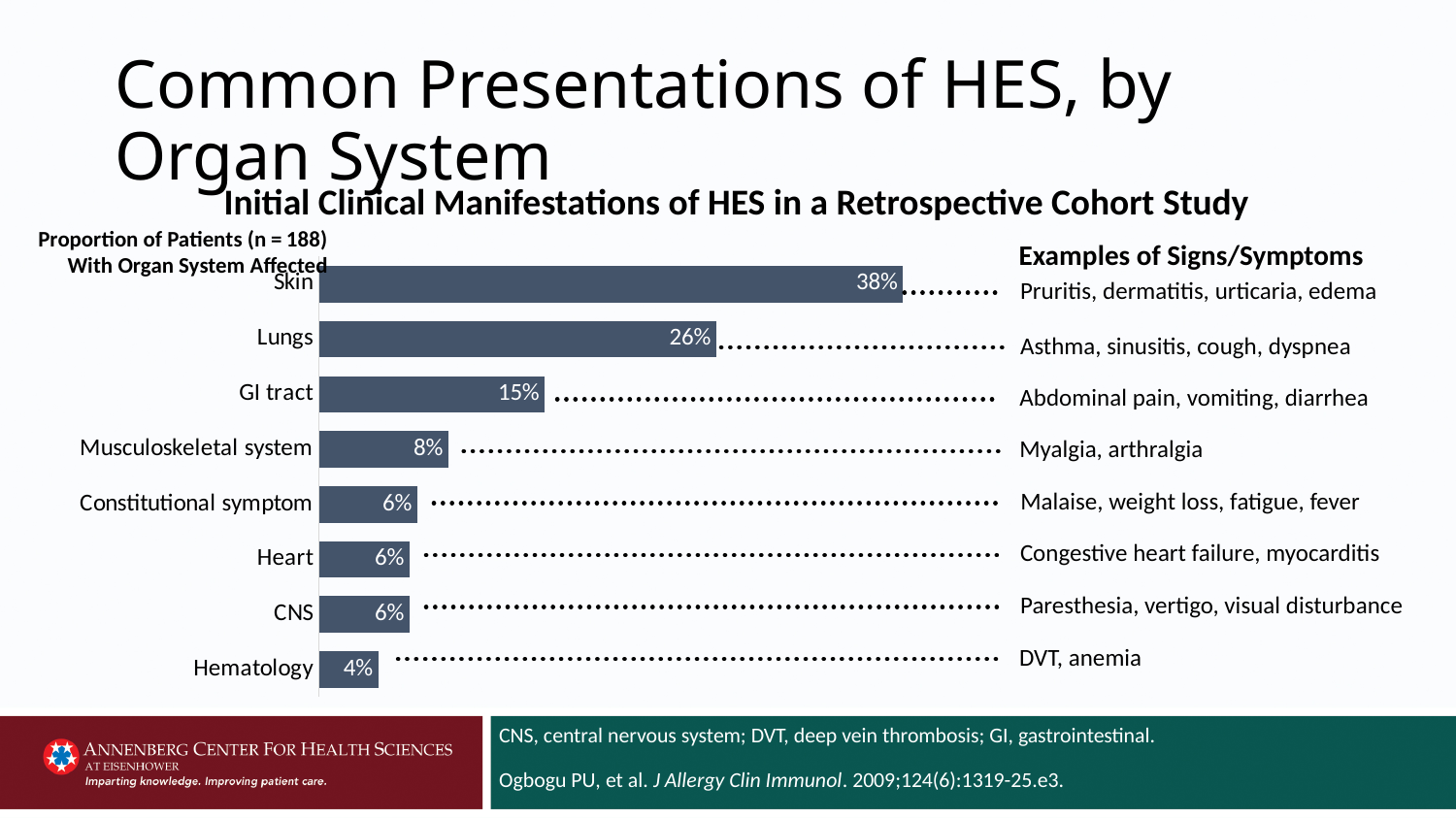
What is the difference between the proportion for Skin and the proportion for Lungs? 12% What is the difference between the proportion for GI tract and the proportion for Hematology? 11% How many patients were in the cohort (n) according to the chart's axis label? 188 What kind of chart is shown on the slide? Bar chart What proportion of patients had the GI tract affected? 15% What proportion of patients had the musculoskeletal system affected? 8% Which has a larger proportion of patients affected, Lungs or GI tract? Lungs Which organ system has the lowest proportion of patients affected? Hematology What proportion of patients had the skin affected? 38% Which organ system has the highest proportion of patients affected? Skin What is the title of the chart? Initial Clinical Manifestations of HES in a Retrospective Cohort Study How many organ systems are shown in the chart? 8